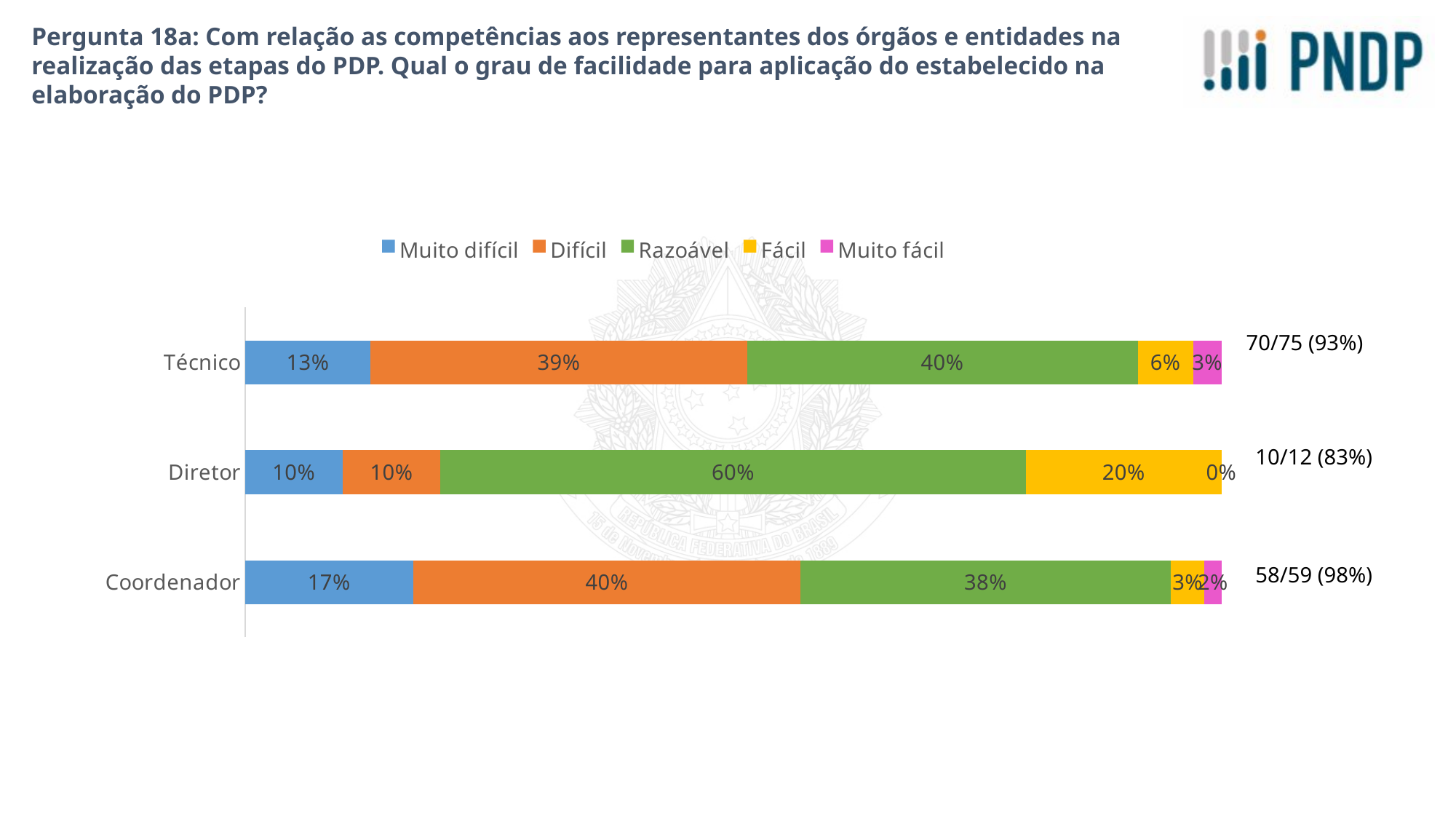
What is the value of 'Fácil' for Diretor? 20% Which category has the lowest value for 'Muito fácil'? Diretor Which is larger: the 'Muito difícil' value for Técnico or for Coordenador? Coordenador What is the value of 'Razoável' for Diretor? 60% How many series does the legend list? 5 How many categories are shown on the vertical axis? 3 What response count annotation is shown next to the Coordenador bar? 58/59 (98%) What is the value of 'Muito difícil' for Coordenador? 17% Which category has the highest value for 'Razoável'? Diretor What is the value of 'Difícil' for Técnico? 39% What is the difference between the 'Difícil' values for Coordenador and Diretor? 30% What type of chart is shown on the slide? Stacked bar chart